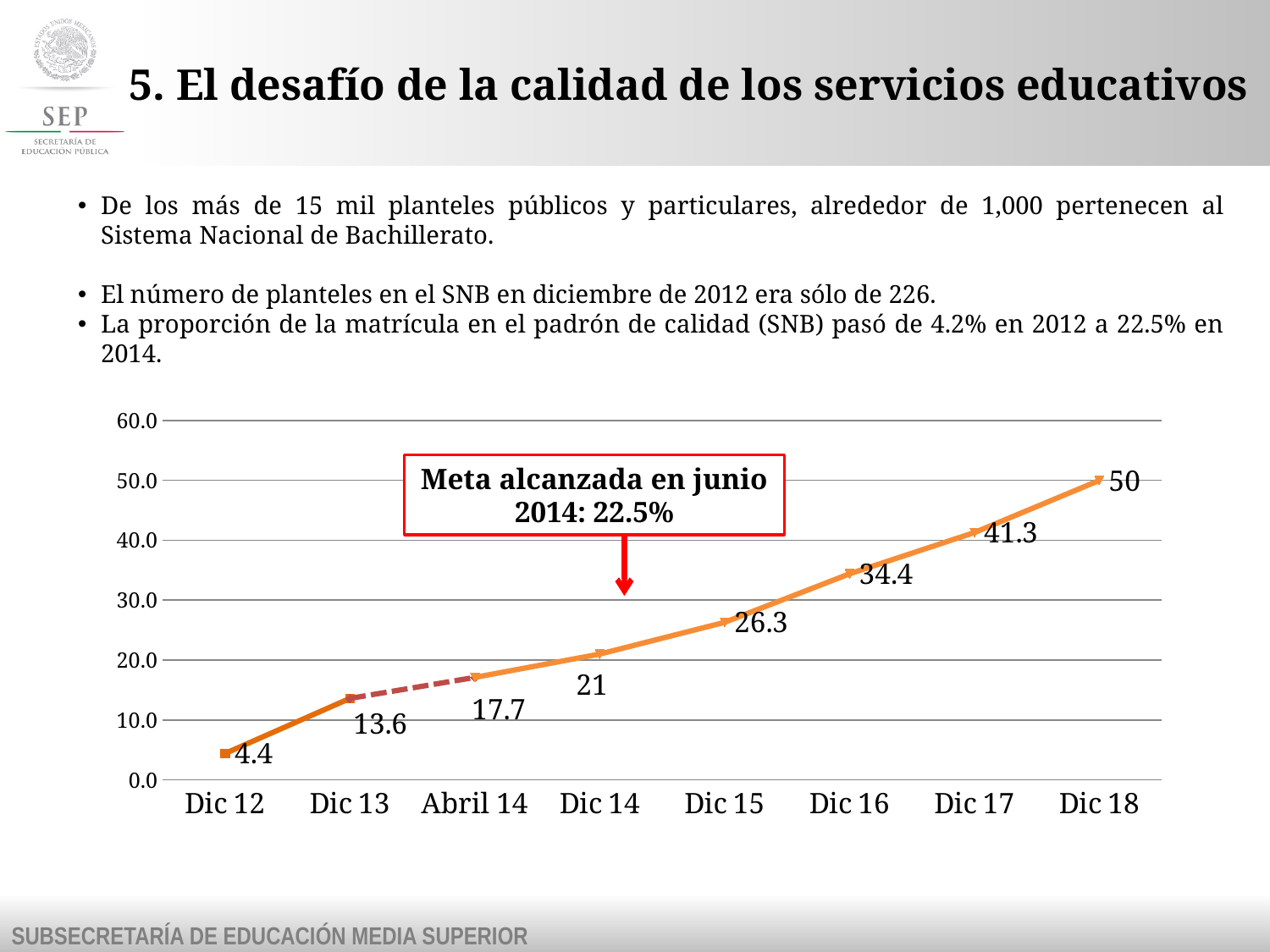
What is the difference between the values for Dic 17 and Dic 16? 6.9 How many data points are plotted on the chart? 8 What is the value plotted for Abril 14? 17.7 What is the value plotted for Dic 14? 21 What kind of chart is shown on the slide? Line chart What is the value plotted for Dic 16? 34.4 Which category has the highest value on the chart? Dic 18 What is the difference between the values for Dic 18 and Dic 12? 45.6 Do the plotted values rise or fall from Dic 12 to Dic 18? Rise Which is larger, the value for Dic 15 or the value for Dic 13? Dic 15 What does the red-bordered annotation box on the chart say? Meta alcanzada en junio 2014: 22.5% Which category has the lowest value on the chart? Dic 12